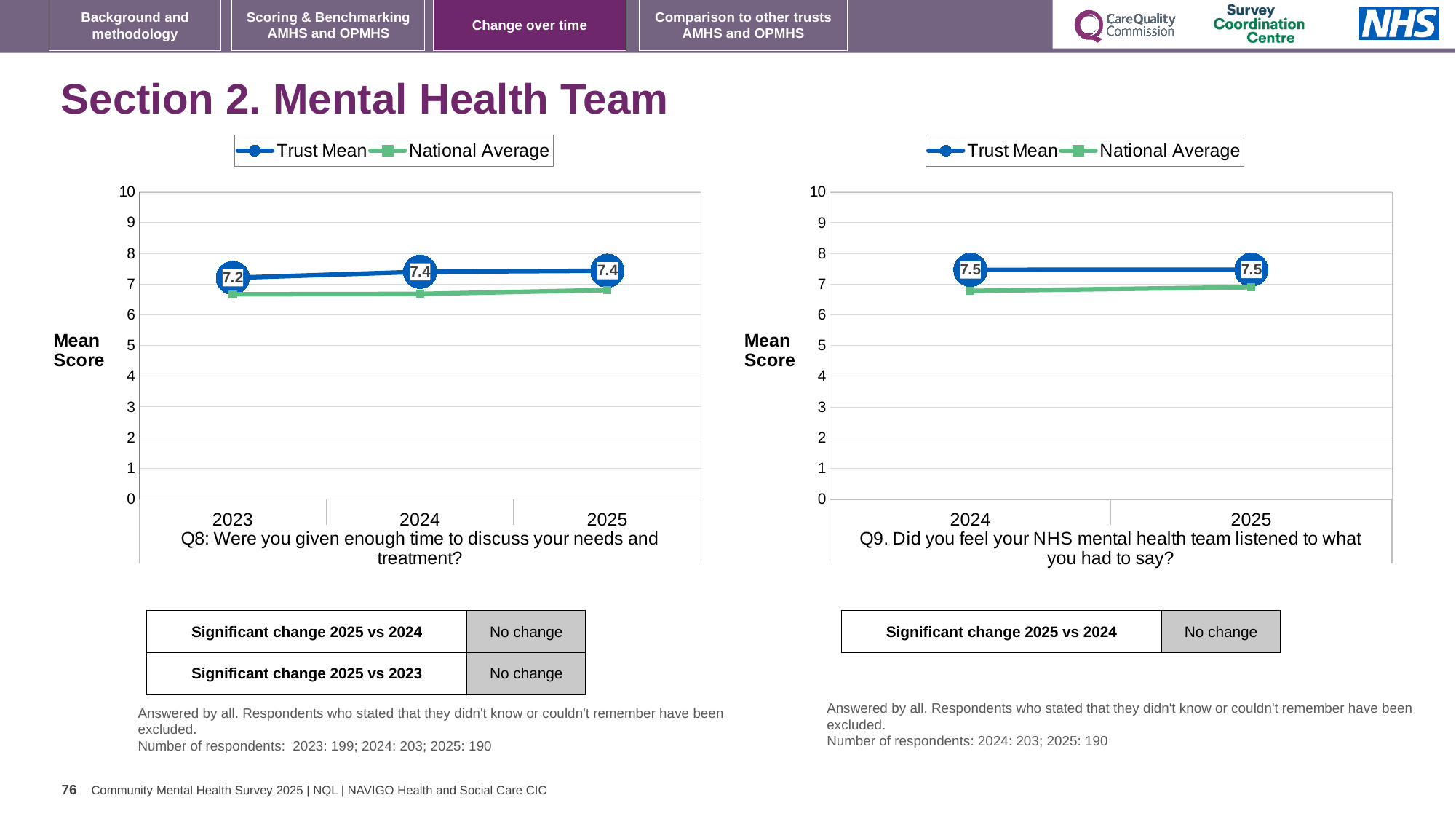
In the left chart (Q8), what is the Trust Mean for 2023? 7.2 In the right chart (Q9), what is the Trust Mean for 2024? 7.5 In the left chart (Q8), is the Trust Mean or the National Average higher in 2023? Trust Mean In the left chart (Q8), is the National Average for 2025 greater or less than 6? greater What type of chart is used for Q8 on the left? Line chart In the left chart (Q8), what is the difference between the Trust Mean in 2024 and in 2023? 0.2 In the right chart (Q9), does the Trust Mean rise, fall or stay the same from 2024 to 2025? Stays the same How many years are shown on the x axis of the right chart (Q9)? 2 In the left chart (Q8), what is the Trust Mean for 2025? 7.4 In the left chart (Q8), which year has the lowest Trust Mean? 2023 How many series does the legend of the left chart (Q8) list? 2 In the right chart (Q9), is the National Average for 2024 greater or less than 7? less